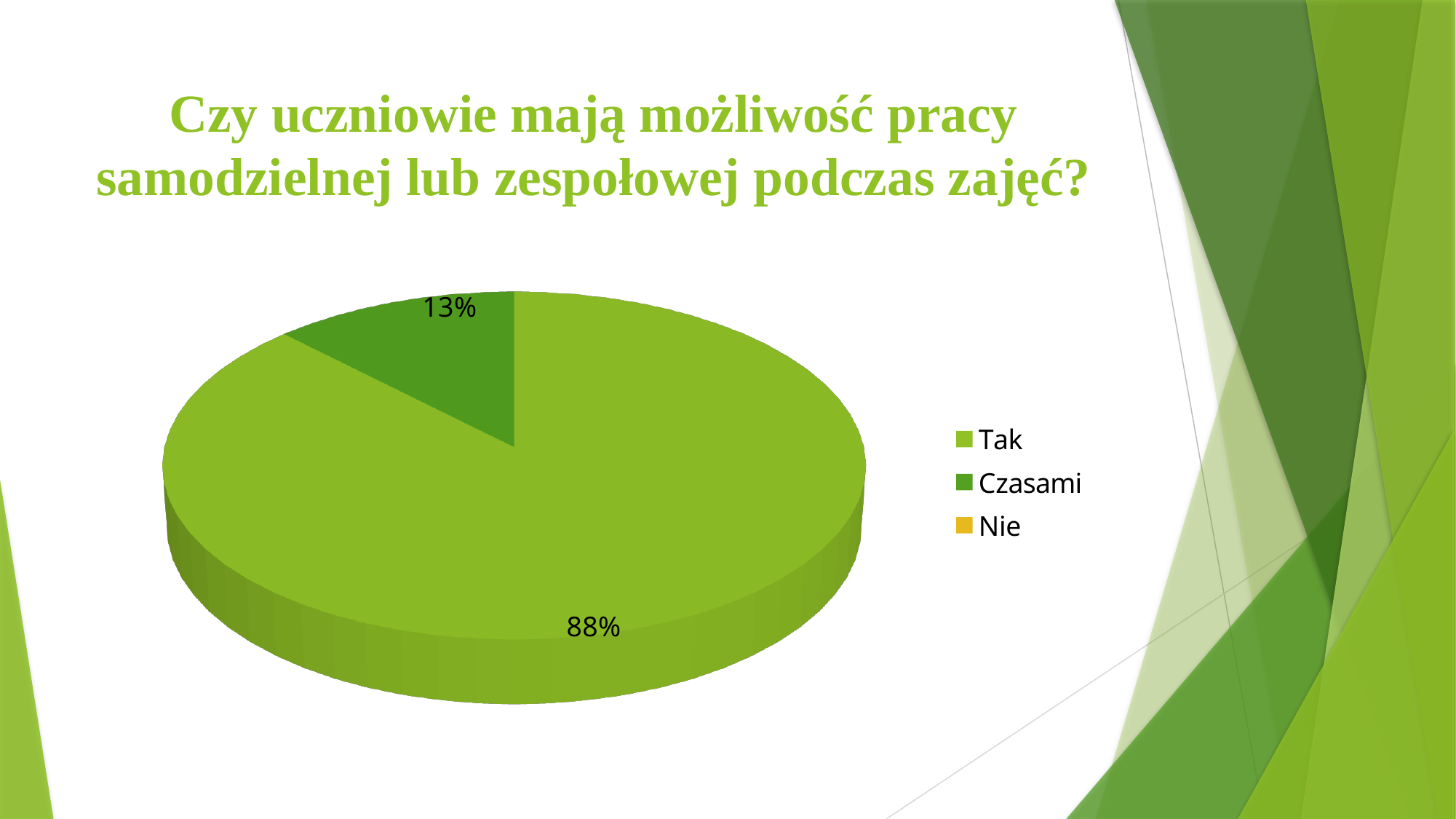
What kind of chart is shown on the slide? pie chart Which of "Tak" or "Czasami" has the larger share? Tak What share of the pie does "Czasami" have? 13% Which category has the largest slice of the pie? Tak How many entries does the legend list? 3 Is the share for "Czasami" greater or less than 25%? less Is the share for "Tak" greater or less than 50%? greater What is the title of the chart on the slide? Czy uczniowie mają możliwość pracy samodzielnej lub zespołowej podczas zajęć? What share of the pie does "Tak" have? 88% Which legend entry is shown in orange/yellow? Nie What is the difference in percentage points between the "Tak" and "Czasami" slices? 75